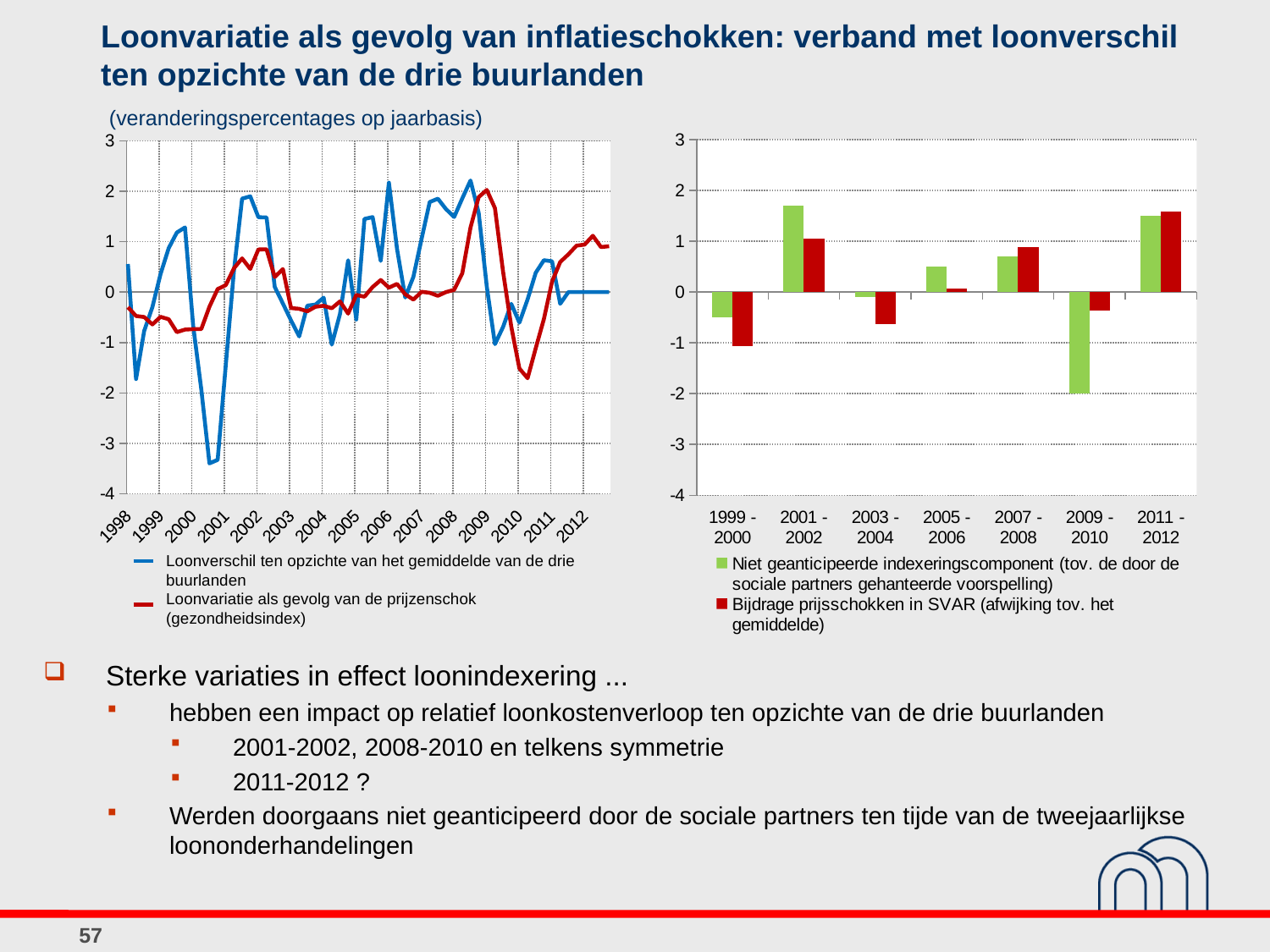
In the right-hand bar chart, which period has the lowest value for 'Niet geanticipeerde indexeringscomponent'? 2009 - 2010 How many series does the legend of the right-hand bar chart list? 2 In the right-hand bar chart, is the value of 'Niet geanticipeerde indexeringscomponent' for 2001 - 2002 greater or less than 1? greater In the right-hand bar chart, for 2001 - 2002, which series has the larger value: 'Niet geanticipeerde indexeringscomponent' or 'Bijdrage prijsschokken in SVAR'? Niet geanticipeerde indexeringscomponent What kind of chart is the chart on the right of the slide? bar chart In the left-hand line chart, which colour is used for the series 'Loonvariatie als gevolg van de prijzenschok (gezondheidsindex)'? red In the left-hand line chart, in which year does the blue line 'Loonverschil ten opzichte van het gemiddelde van de drie buurlanden' reach its lowest point? 2000 How many period categories are shown on the x axis of the right-hand bar chart? 7 What kind of chart is the chart on the left of the slide? line chart In the right-hand bar chart, which period has the lowest value for 'Bijdrage prijsschokken in SVAR'? 1999 - 2000 In the right-hand bar chart, which period has the highest value for 'Bijdrage prijsschokken in SVAR'? 2011 - 2012 In the right-hand bar chart, is the value of 'Niet geanticipeerde indexeringscomponent' for 2009 - 2010 greater or less than -1? less